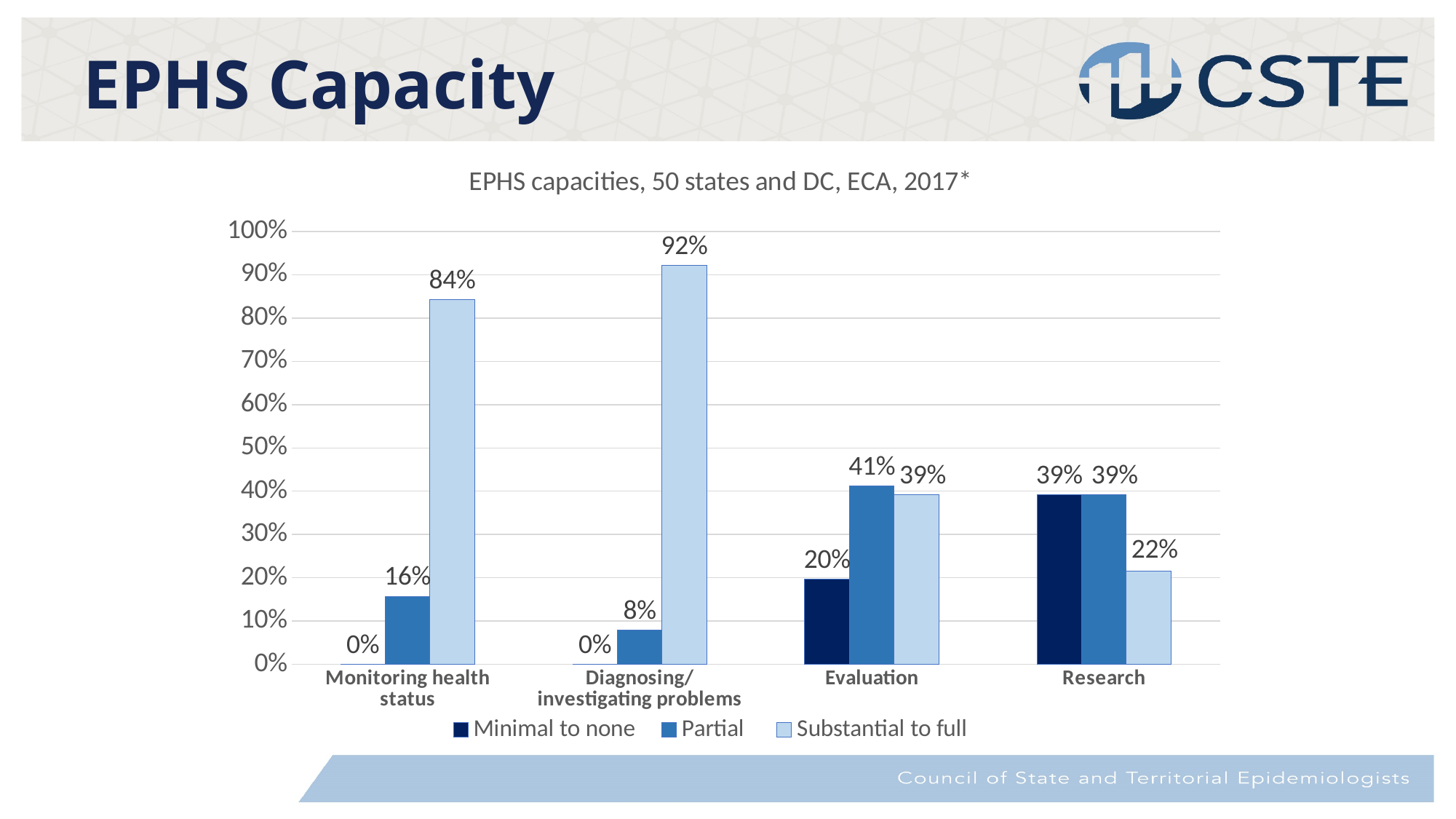
What is the value for Partial in the Monitoring health status category? 16% Which category has the highest Substantial to full value? Diagnosing/investigating problems What kind of chart is shown on the slide? Bar chart What is the value for Minimal to none in the Evaluation category? 20% How many series does the legend list? 3 What is the title of the chart? EPHS capacities, 50 states and DC, ECA, 2017* How many categories are shown on the x axis? 4 What is the value for Substantial to full in the Research category? 22% What is the difference between the Substantial to full values for Diagnosing/investigating problems and Monitoring health status? 8% Which is larger in the Evaluation category: Partial or Substantial to full? Partial What is the value for Substantial to full in the Diagnosing/investigating problems category? 92% Which category has the lowest Substantial to full value? Research